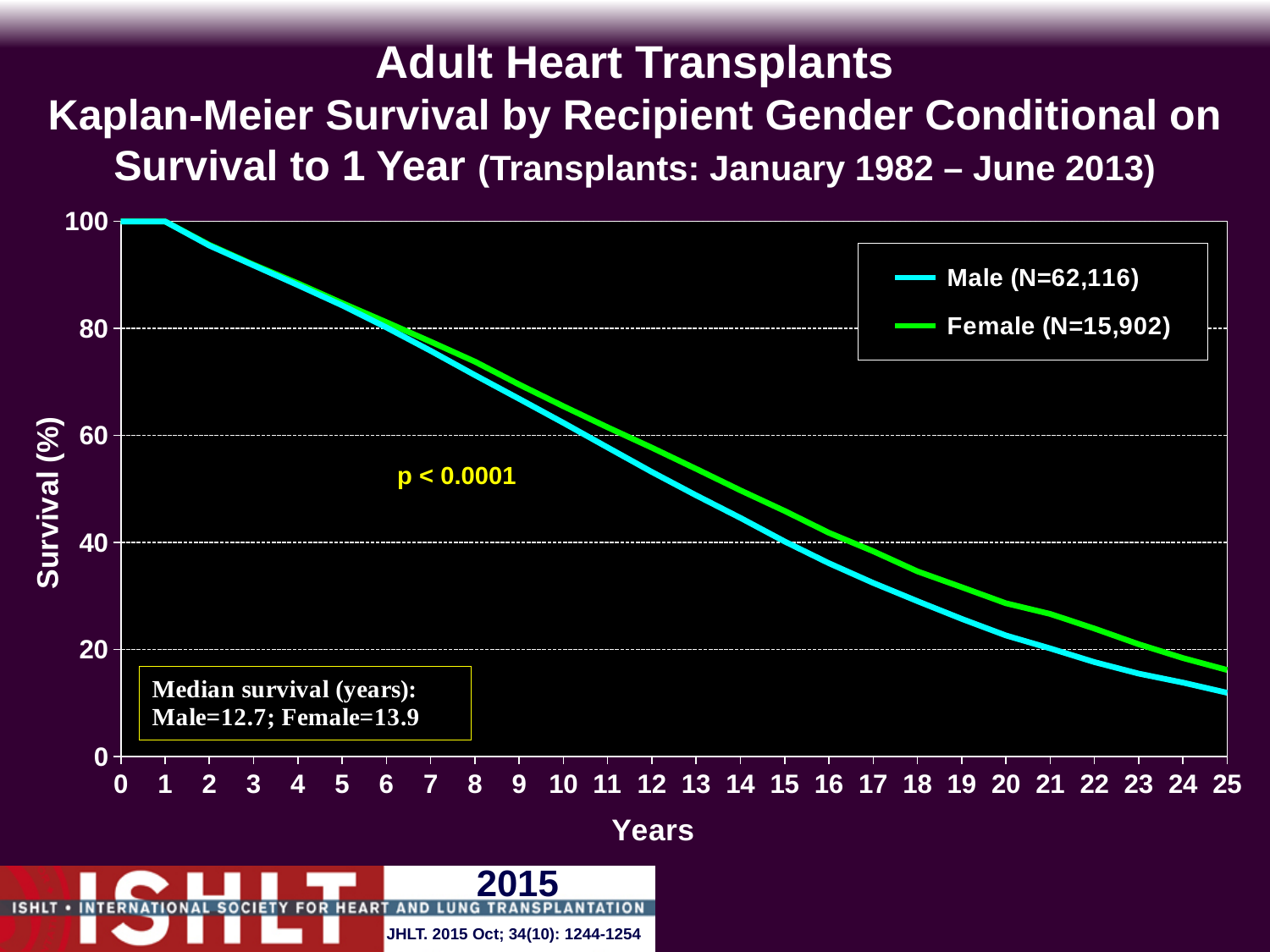
What kind of chart is shown on the slide? line chart What is the N shown in the legend for the Male series? 62,116 At 15 years, which series shows higher survival, Male or Female? Female Is the survival value for Female at 25 years greater or less than 20? less Which recipient gender has the higher median survival? Female What p-value is printed on the chart? p < 0.0001 Do the survival curves rise or fall as years increase? fall How many series does the legend list? 2 What is the median survival in years for male recipients? 12.7 Is the survival value for Male at 5 years greater or less than 80? greater What is the difference in median survival (years) between female and male recipients? 1.2 What is the median survival in years for female recipients? 13.9